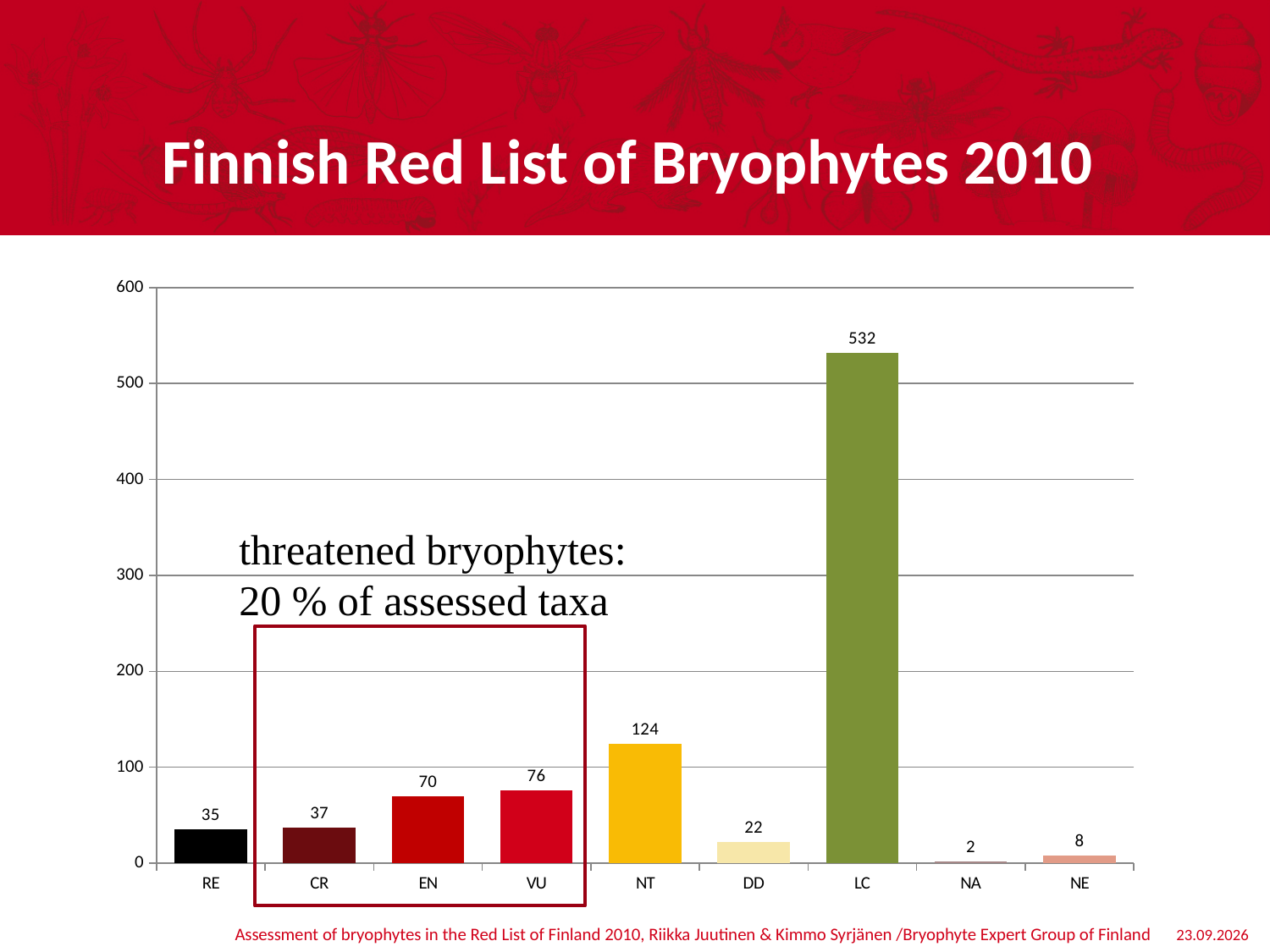
What is the value for CR? 37 What is the total of the values for CR, EN and VU? 183 What is the value for NT? 124 Is the value for NT greater or less than 100? greater Which categories are enclosed by the red box on the chart? CR, EN, VU How many categories are shown on the x axis? 9 Which category has the lowest value? NA Which is larger, the value for RE or the value for DD? RE What is the difference between the values for VU and EN? 6 What kind of chart is shown on the slide? bar chart Which category has the highest value? LC What is the value for LC? 532